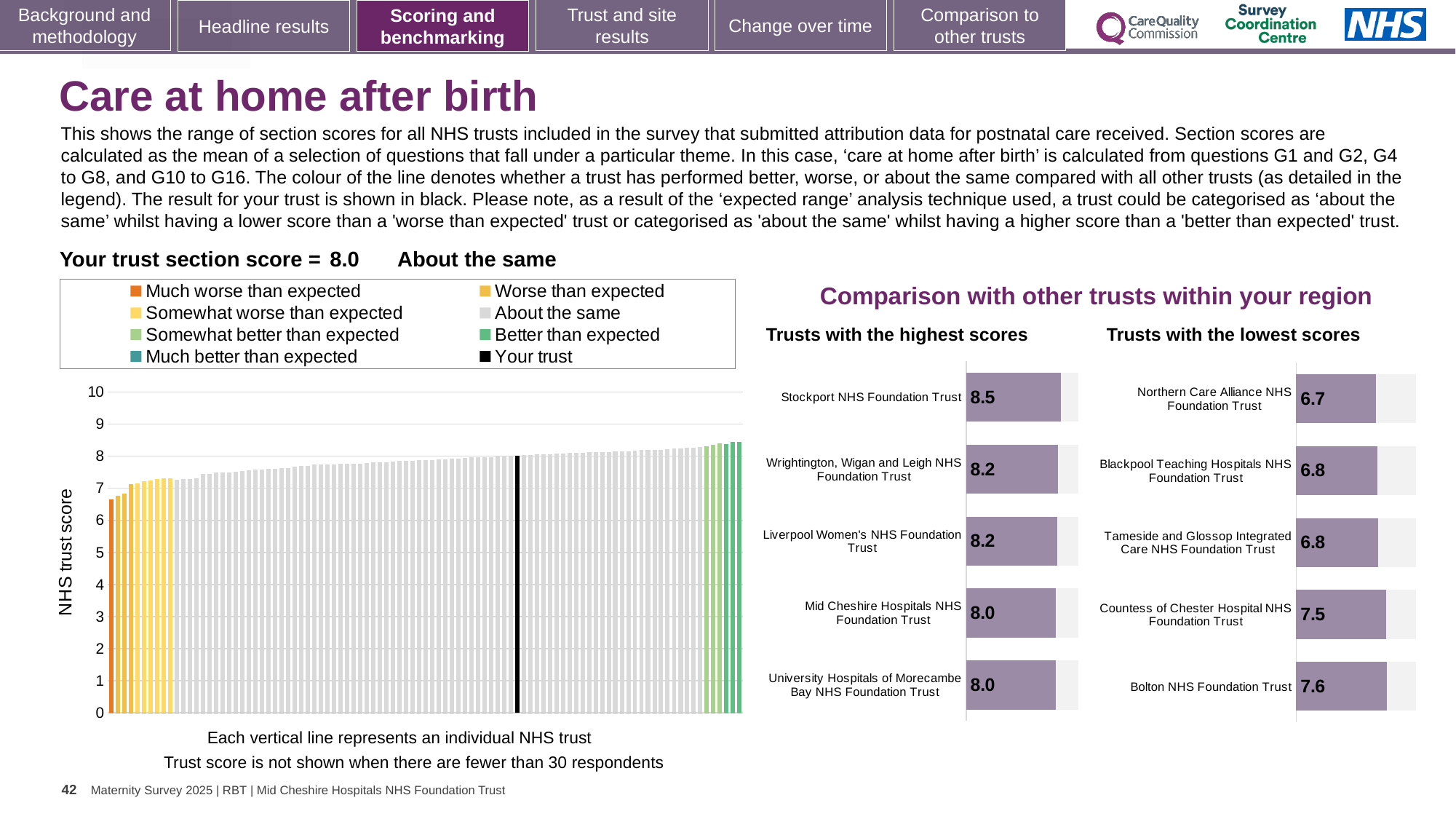
In the 'Trusts with the lowest scores' chart, which has the higher score: Countess of Chester Hospital NHS Foundation Trust or Bolton NHS Foundation Trust? Bolton NHS Foundation Trust In the 'Trusts with the lowest scores' chart, what is the difference between the scores of Countess of Chester Hospital NHS Foundation Trust and Northern Care Alliance NHS Foundation Trust? 0.8 How many entries does the legend above the large 'NHS trust score' chart list? 8 In the 'Trusts with the highest scores' chart, which trust has the highest score? Stockport NHS Foundation Trust How many trusts are shown in the 'Trusts with the highest scores' chart? 5 What kind of chart is the 'Trusts with the highest scores' chart? Bar chart In the 'Trusts with the lowest scores' chart, what is the score for Northern Care Alliance NHS Foundation Trust? 6.7 In the 'Trusts with the lowest scores' chart, which trust has the lowest score? Northern Care Alliance NHS Foundation Trust In the large 'NHS trust score' chart on the left, do the values rise or fall from left to right along the x axis? Rise In the 'Trusts with the highest scores' chart, what is the score for Stockport NHS Foundation Trust? 8.5 In the 'Trusts with the highest scores' chart, what is the difference between the scores of Stockport NHS Foundation Trust and Mid Cheshire Hospitals NHS Foundation Trust? 0.5 In the 'Trusts with the lowest scores' chart, what is the score for Bolton NHS Foundation Trust? 7.6